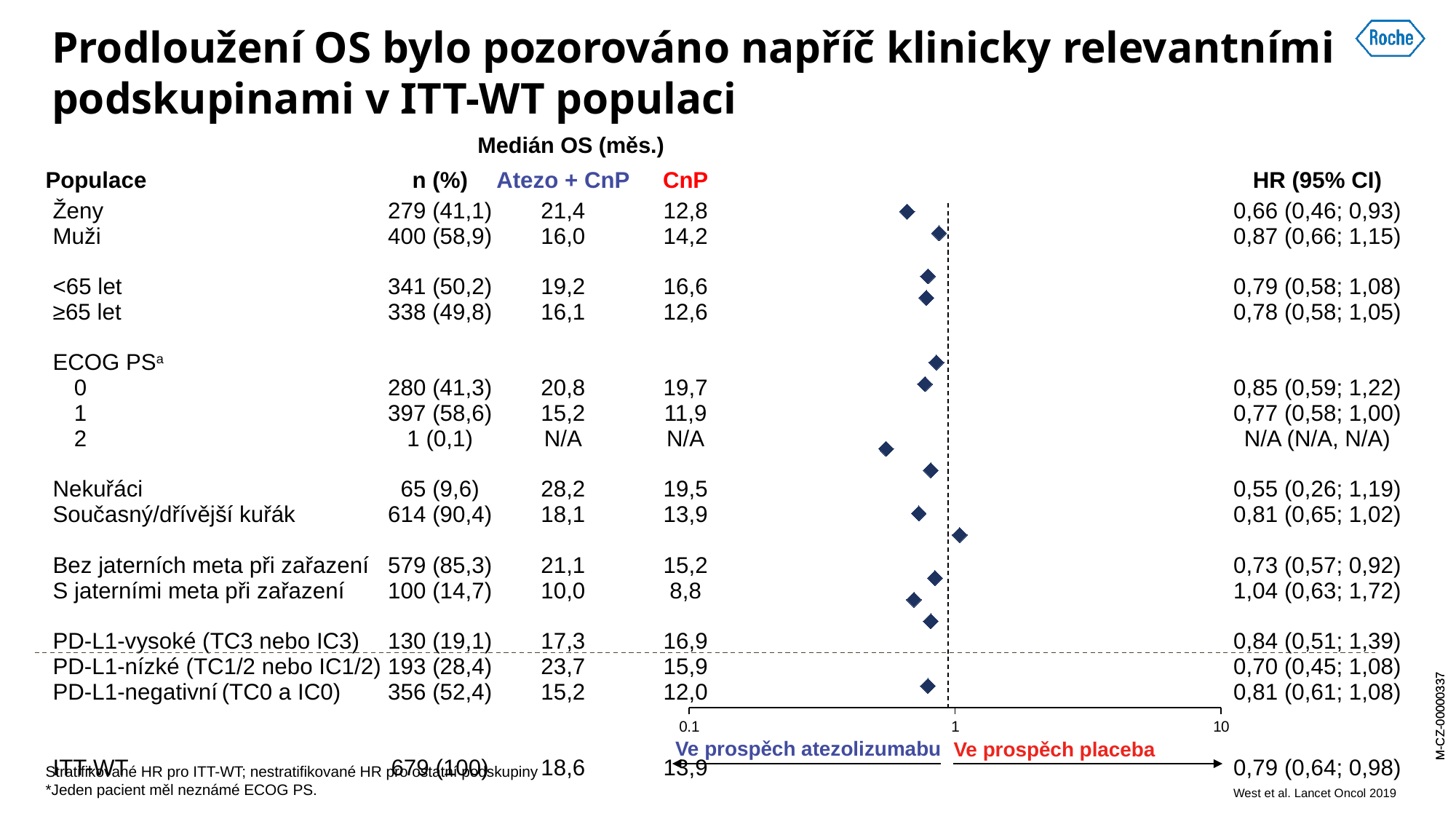
What is the HR (95% CI) for the ITT-WT population? 0,79 (0,64; 0,98) What is the median OS (months) for Atezo + CnP in the Nekuřáci subgroup? 28,2 Which subgroup has the lower HR point estimate, Ženy or Muži? Ženy For the Ženy subgroup, what is the difference in median OS between Atezo + CnP and CnP? 8,6 What is the HR (95% CI) for the Ženy subgroup? 0,66 (0,46; 0,93) Which subgroup has the highest HR point estimate? S jaterními meta při zařazení Which side of the reference line is labelled as favouring atezolizumab? Left (Ve prospěch atezolizumabu) What is the n (%) for the ITT-WT population? 679 (100) Which subgroup has the lowest HR point estimate? Nekuřáci What kind of chart is shown on the slide? Forest plot Is the HR point estimate for S jaterními meta při zařazení greater or less than 1? greater What is the median OS (months) for CnP in the Muži subgroup? 14,2